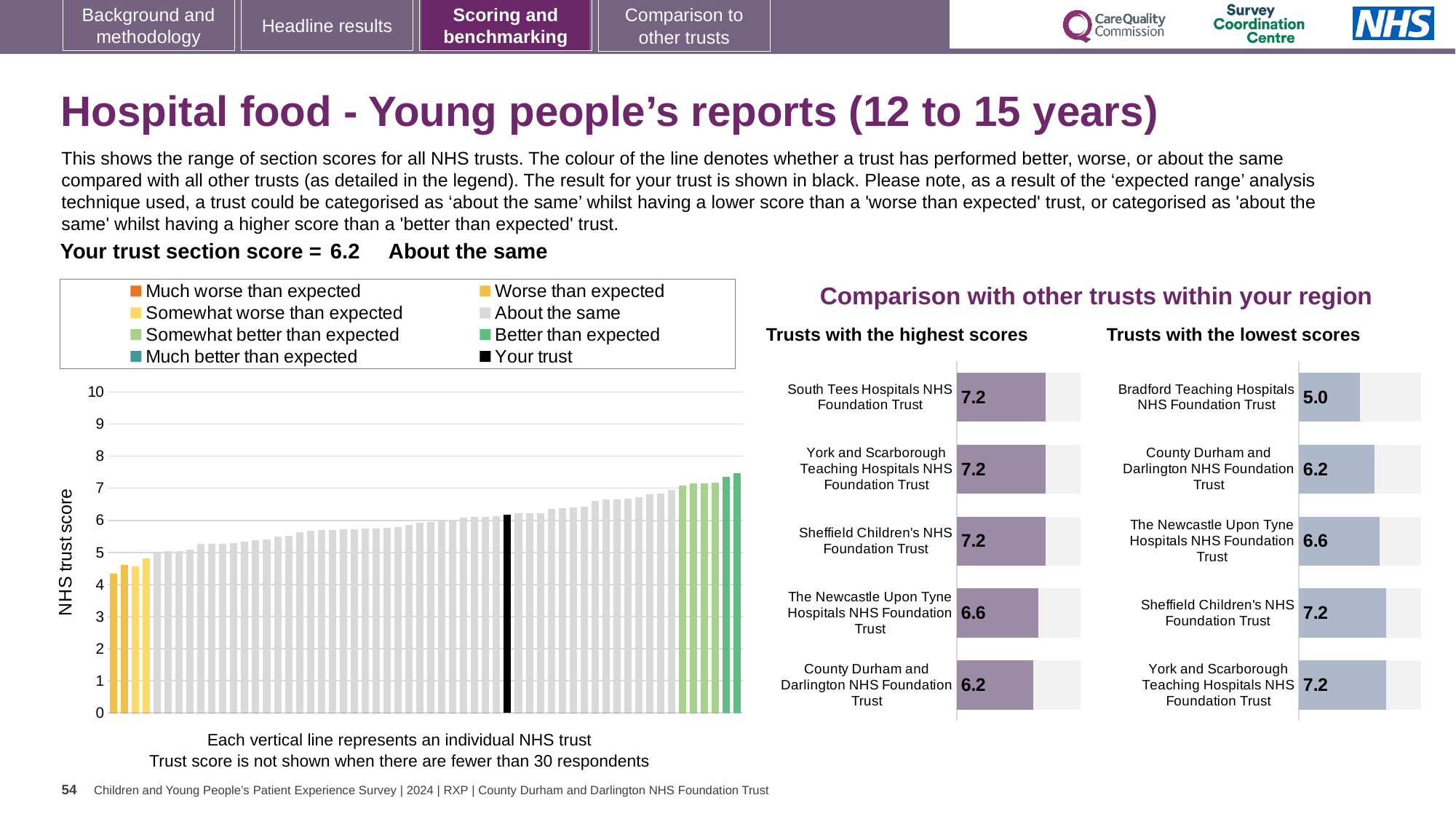
How many entries does the legend of the main chart on the left list? 8 In the 'Trusts with the lowest scores' chart, what is the difference between the scores of Sheffield Children's NHS Foundation Trust and Bradford Teaching Hospitals NHS Foundation Trust? 2.2 In the 'Trusts with the highest scores' chart, which has the higher score: The Newcastle Upon Tyne Hospitals NHS Foundation Trust or County Durham and Darlington NHS Foundation Trust? The Newcastle Upon Tyne Hospitals NHS Foundation Trust What kind of chart is the main chart on the left of the slide? bar chart In the 'Trusts with the lowest scores' chart, what is the score for Bradford Teaching Hospitals NHS Foundation Trust? 5.0 In the main chart on the left, is the value for the black bar (your trust) greater or less than 5? greater In the 'Trusts with the highest scores' chart, what is the difference between the scores of South Tees Hospitals NHS Foundation Trust and County Durham and Darlington NHS Foundation Trust? 1.0 In the 'Trusts with the lowest scores' chart, which trust has the lowest score? Bradford Teaching Hospitals NHS Foundation Trust How many trusts are listed in the 'Trusts with the lowest scores' chart? 5 In the 'Trusts with the highest scores' chart, what is the score for South Tees Hospitals NHS Foundation Trust? 7.2 In the 'Trusts with the lowest scores' chart, do the scores rise or fall from top to bottom? rise In the 'Trusts with the highest scores' chart, what is the score for The Newcastle Upon Tyne Hospitals NHS Foundation Trust? 6.6